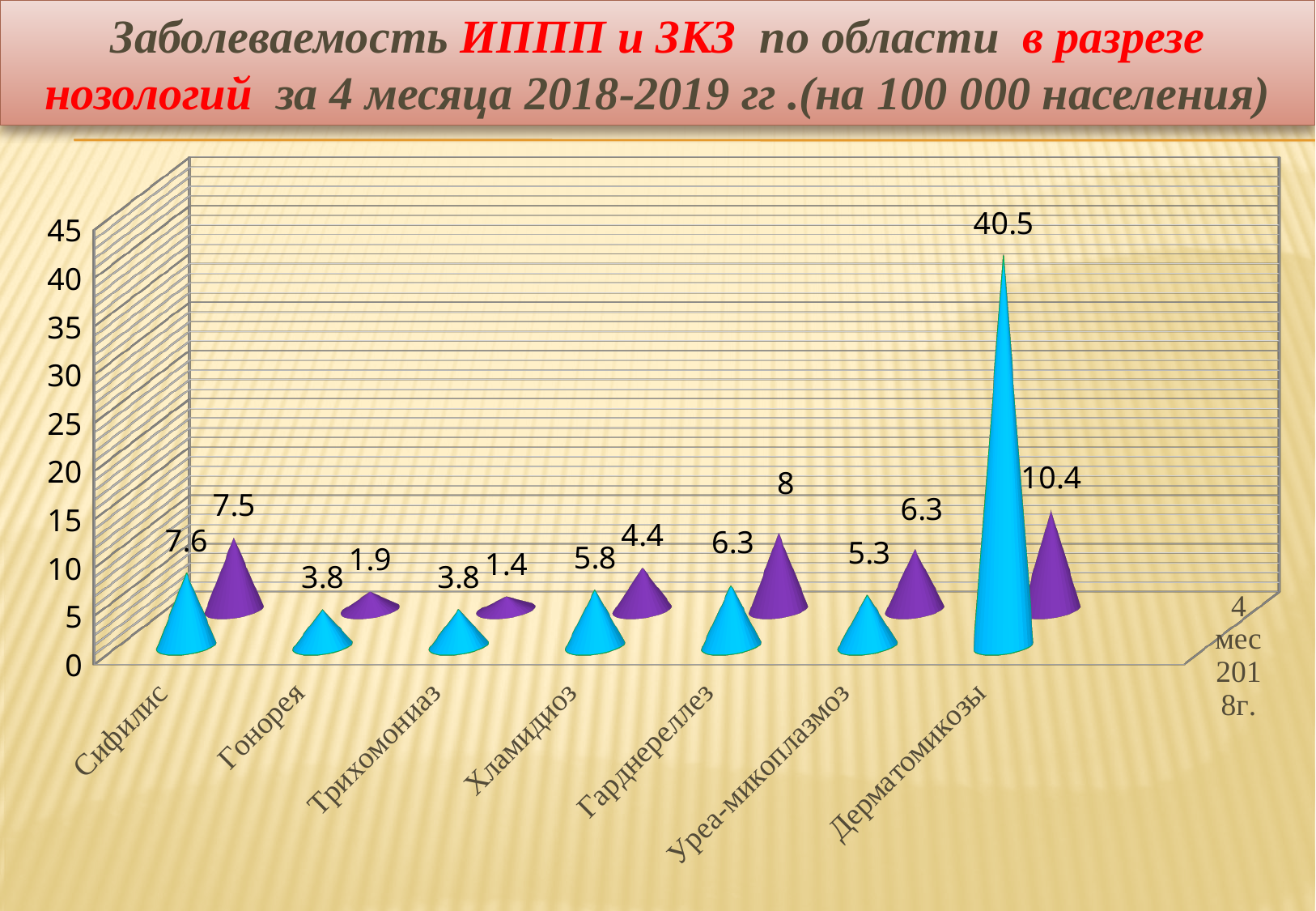
Which category has the highest value among the blue cones? Дерматомикозы How many categories are shown on the x axis? 7 For Уреа-микоплазмоз, which is larger: the blue cone or the purple cone? the purple cone What is the difference between the blue and purple cone values for Гонорея? 1.9 What is the value of the blue cone for Сифилис? 7.6 What is the value of the purple cone for Трихомониаз? 1.4 Which series label is readable on the depth axis of the chart? 4 мес 2018г. Which category has the lowest value among the purple cones? Трихомониаз What kind of chart is shown on the slide? bar chart What is the value of the purple cone for Гарднереллез? 8 What is the difference between the blue and purple cone values for Дерматомикозы? 30.1 What is the value of the blue cone for Дерматомикозы? 40.5